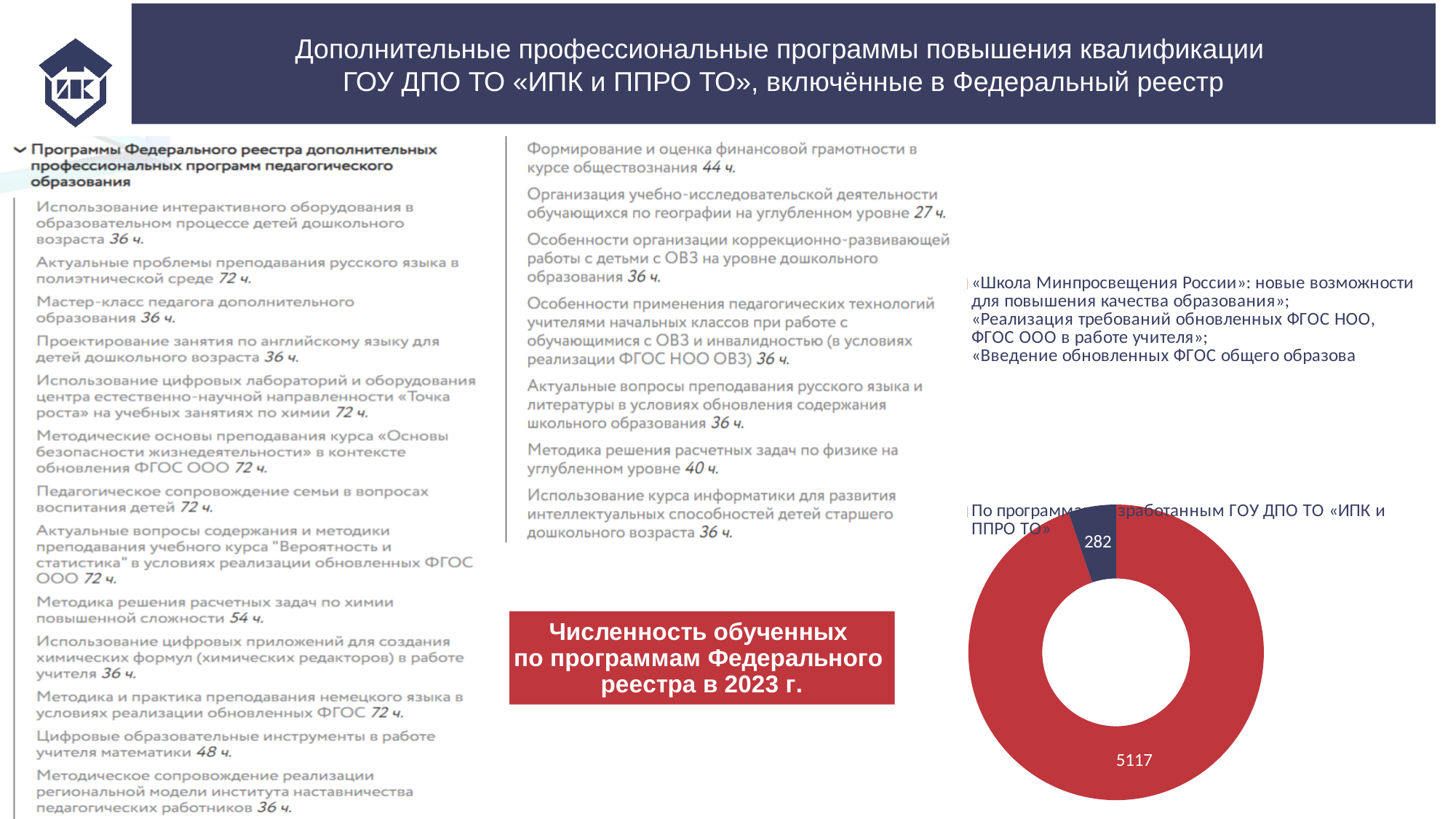
What is the difference between the two values shown on the doughnut chart? 4835 How many slices does the doughnut chart have? 2 What value is shown on the large red slice of the doughnut chart? 5117 What is the title of the chart on the slide? Численность обученных по программам Федерального реестра в 2023 г. Which slice of the doughnut chart has the largest value? the red slice (5117) How many entries does the legend of the doughnut chart list? 2 What is the total of the two values shown on the doughnut chart? 5399 Which is larger on the doughnut chart: the red slice or the dark blue slice? the red slice What value is shown on the small dark blue slice of the doughnut chart? 282 Which slice of the doughnut chart has the smallest value? the dark blue slice (282) What kind of chart is shown on the right side of the slide? doughnut chart What share of the doughnut chart total does the red slice (5117) represent? 94.8%